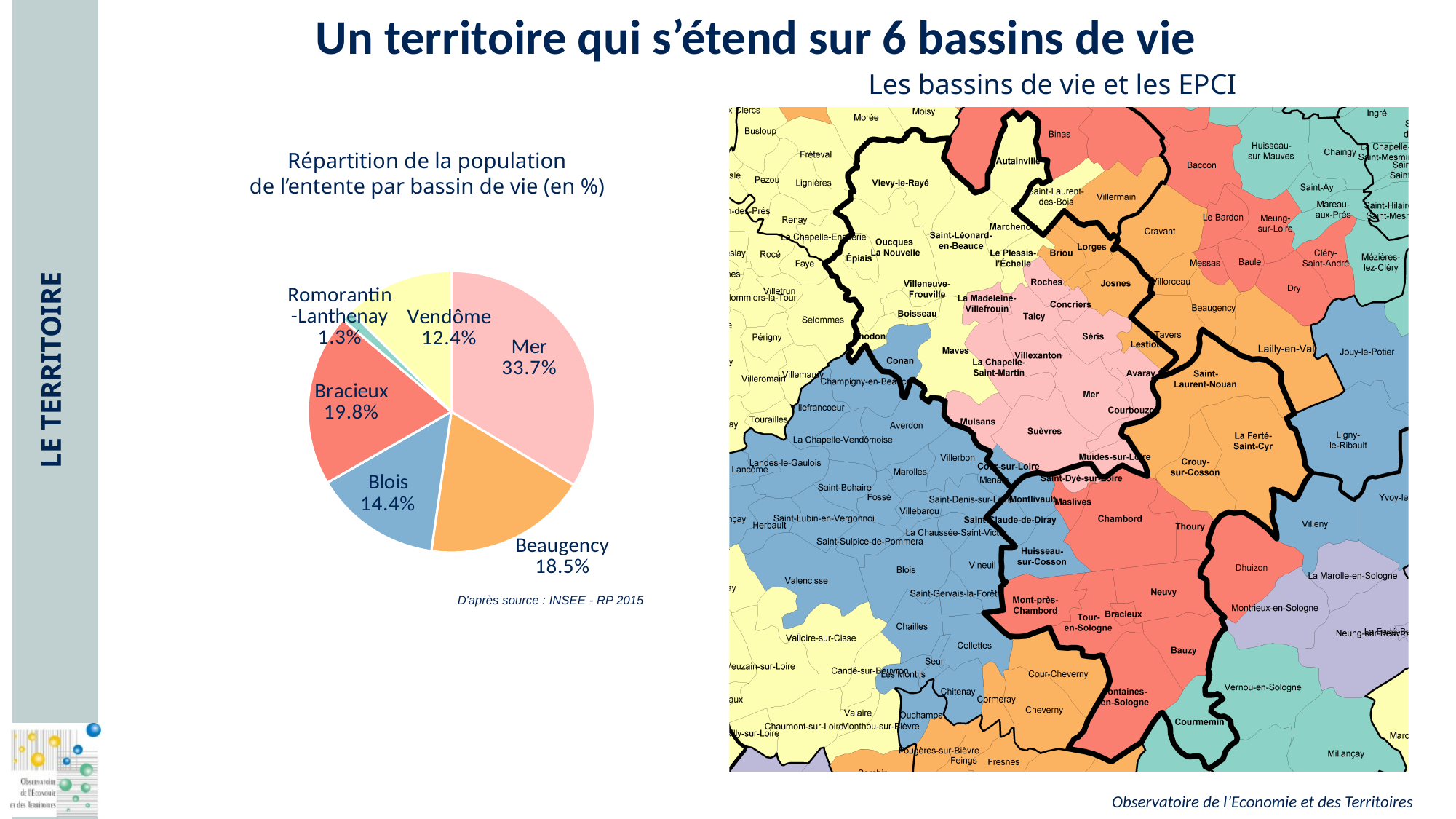
What percentage is shown for Beaugency in the pie chart? 18.5% What is the title of the pie chart? Répartition de la population de l'entente par bassin de vie (en %) What is the difference in percentage points between the Mer and Bracieux shares in the pie chart? 13.9 Which bassin de vie has the largest share of the population in the pie chart? Mer How many bassins de vie (slices) are shown in the pie chart? 6 What share of the population does the Mer bassin de vie account for in the pie chart? 33.7% What percentage is shown for Blois in the pie chart? 14.4% Which has a larger share in the pie chart, Blois or Vendôme? Blois Which has a larger share in the pie chart, Bracieux or Beaugency? Bracieux What type of chart is used to show the population distribution by bassin de vie? Pie chart What percentage is shown for Romorantin-Lanthenay in the pie chart? 1.3% Which bassin de vie has the smallest share of the population in the pie chart? Romorantin-Lanthenay